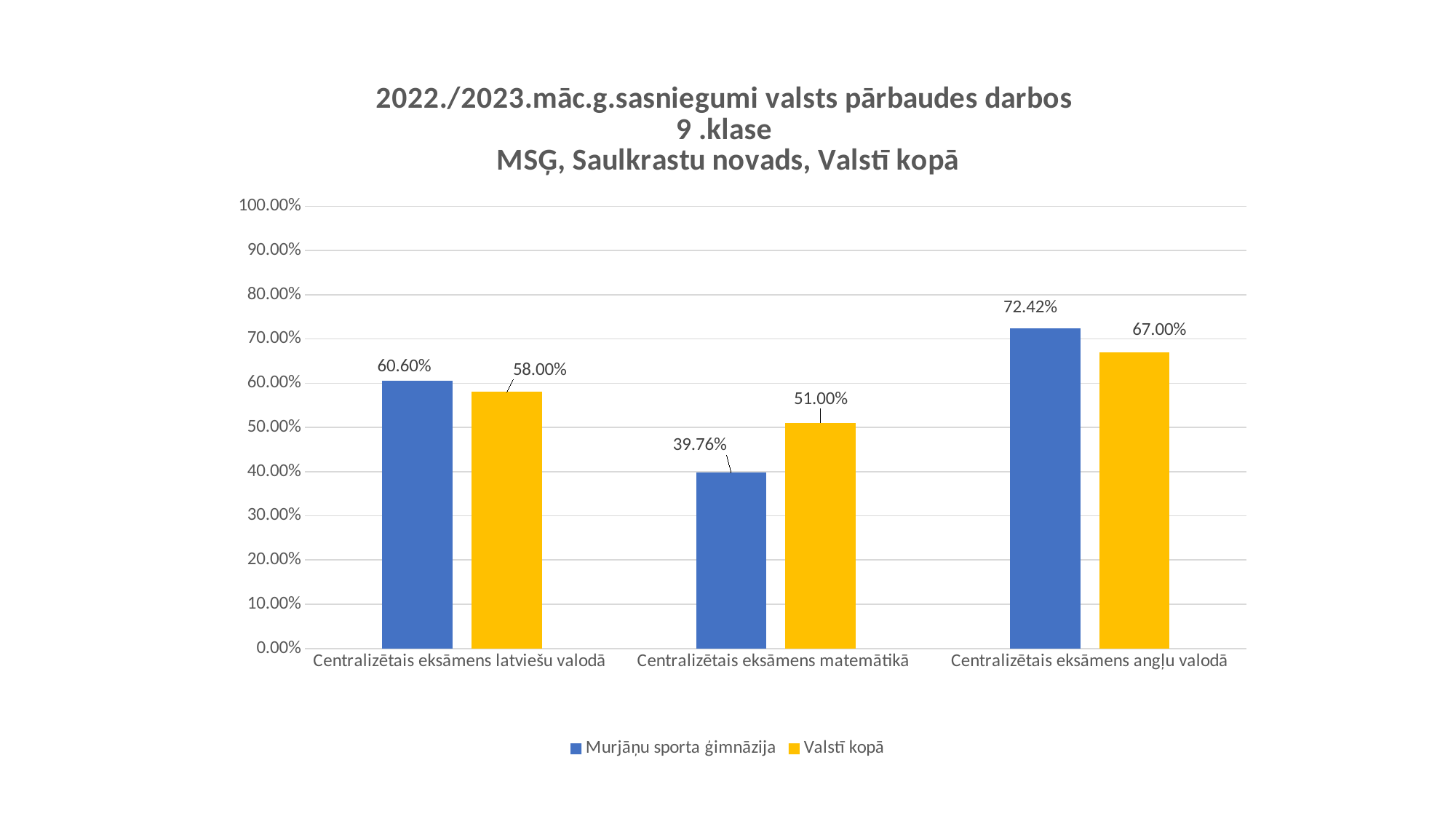
Which exam has the highest value for Murjāņu sporta ģimnāzija? Centralizētais eksāmens angļu valodā What is the value for Valstī kopā in Centralizētais eksāmens matemātikā? 51.00% How many exam categories are shown on the x axis? 3 Which is larger in Centralizētais eksāmens latviešu valodā: Murjāņu sporta ģimnāzija or Valstī kopā? Murjāņu sporta ģimnāzija Which colour represents Valstī kopā in the chart? Yellow What kind of chart is shown on the slide? Bar chart Which exam has the lowest value for Valstī kopā? Centralizētais eksāmens matemātikā What is the value for Murjāņu sporta ģimnāzija in Centralizētais eksāmens angļu valodā? 72.42% What is the value for Murjāņu sporta ģimnāzija in Centralizētais eksāmens latviešu valodā? 60.60% How many series does the legend list? 2 What is the difference between Murjāņu sporta ģimnāzija and Valstī kopā in Centralizētais eksāmens matemātikā? 11.24% Is the value for Valstī kopā in Centralizētais eksāmens angļu valodā greater or less than 60.00%? greater